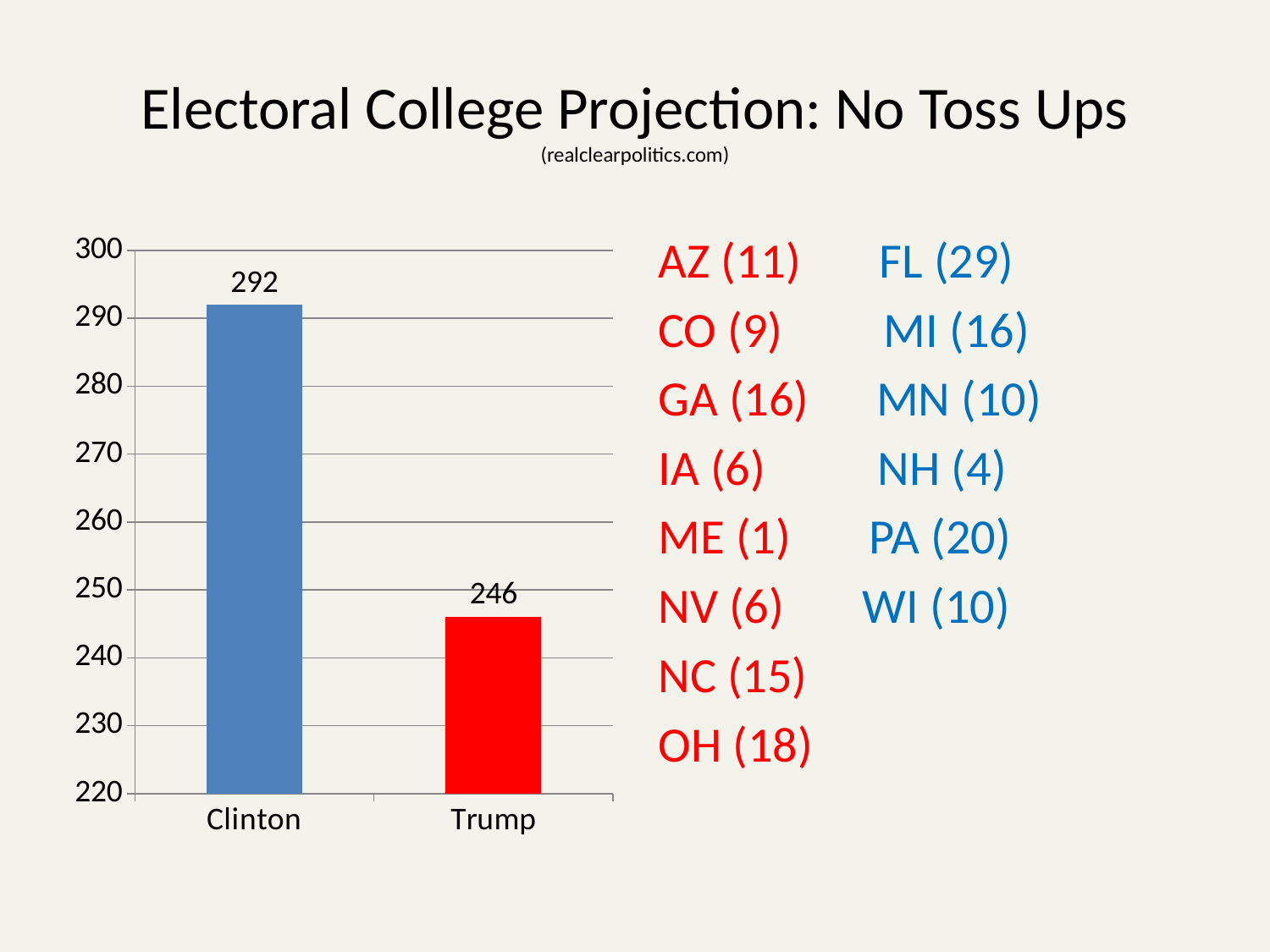
What kind of chart is shown on the slide? bar chart Is the value for Clinton greater or less than 290? greater Which is larger, the value for Clinton or the value for Trump? Clinton What is the value for Clinton? 292 What colour is the bar for Trump? red Which category has the lowest value? Trump What is the difference between the values for Clinton and Trump? 46 Which category has the highest value? Clinton How many categories are shown on the chart? 2 What is the value for Trump? 246 Is the value for Trump greater or less than 250? less What is the title of the slide? Electoral College Projection: No Toss Ups